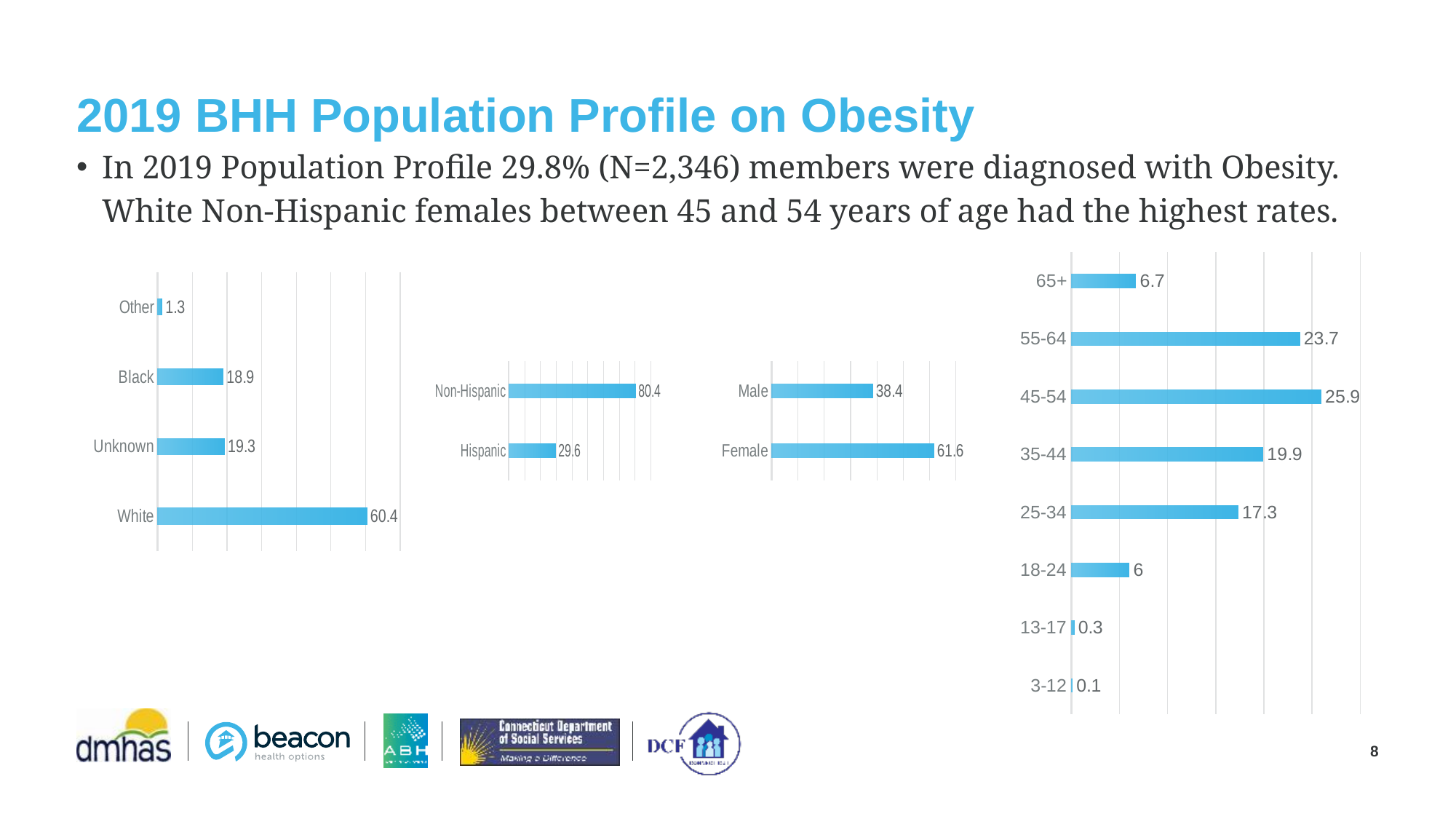
In the rightmost chart (age groups), what is the difference between the values for 45-54 and 35-44? 6 In the rightmost chart (age groups), which age group has the highest value? 45-54 In the leftmost chart (race categories), which category has the lowest value? Other In the rightmost chart (age groups), how many age groups are shown? 8 In the leftmost chart (race categories), what is the value for White? 60.4 In the third chart from the left (gender), what is the value for Male? 38.4 In the leftmost chart (race categories), what is the difference between the values for Unknown and Black? 0.4 In the rightmost chart (age groups), what is the value for 55-64? 23.7 In the third chart from the left (gender), which is larger, Male or Female? Female In the second chart from the left (ethnicity), what is the difference between Non-Hispanic and Hispanic? 50.8 What type of chart is the rightmost chart (age groups)? Bar chart In the second chart from the left (ethnicity), what is the value for Hispanic? 29.6